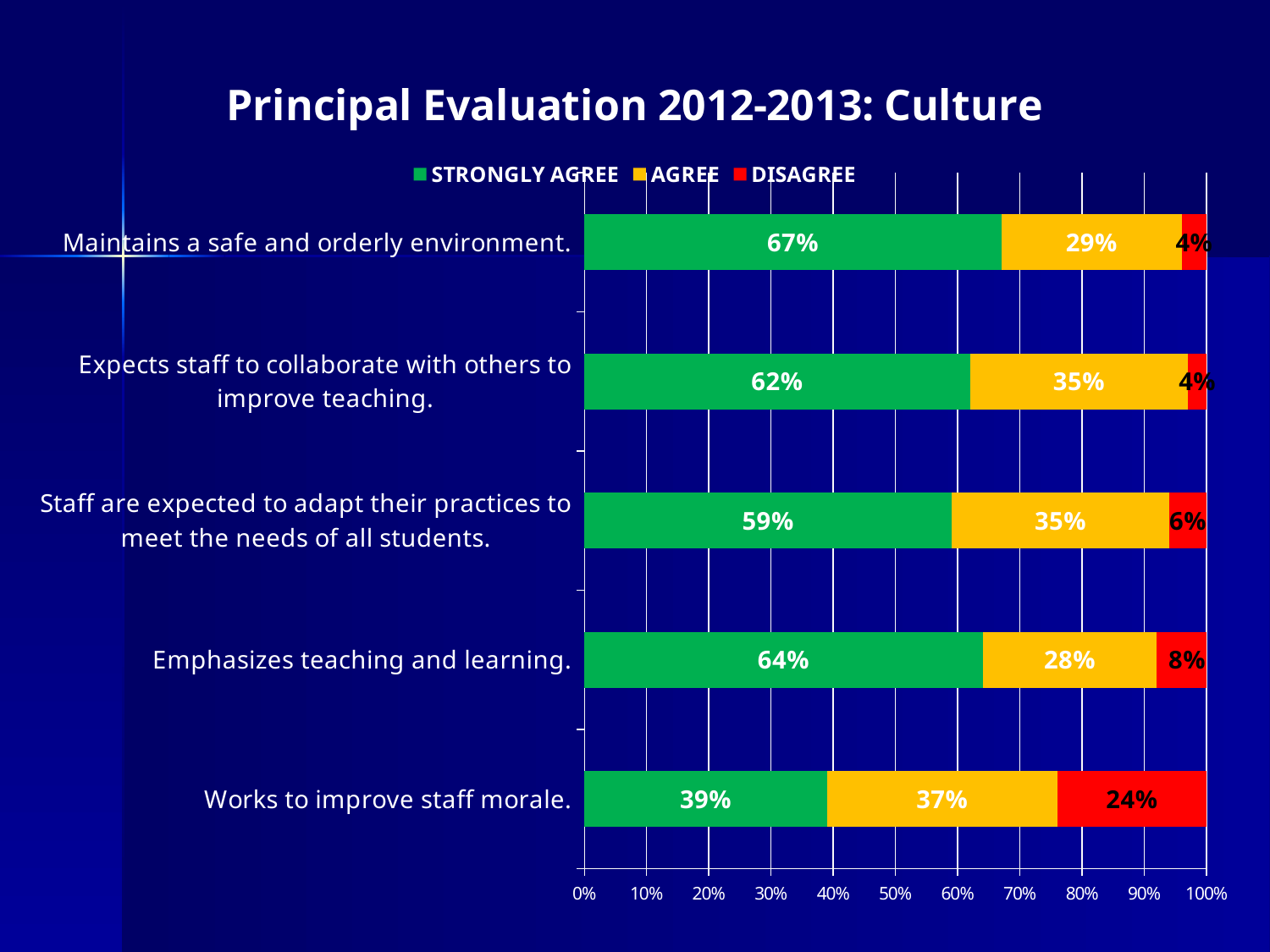
What is the title of the chart? Principal Evaluation 2012-2013: Culture How many series does the legend list? 3 What percentage of respondents strongly agree that the principal maintains a safe and orderly environment? 67% What is the Agree value for "Expects staff to collaborate with others to improve teaching."? 35% Which is larger: the Agree value for "Emphasizes teaching and learning." or the Agree value for "Works to improve staff morale."? Works to improve staff morale. What is the difference between the Strongly Agree values for "Maintains a safe and orderly environment." and "Works to improve staff morale."? 28% How many categories are shown on the chart? 5 What is the Disagree value for "Works to improve staff morale."? 24% Which category has the highest Strongly Agree percentage? Maintains a safe and orderly environment. Which category has the highest Disagree percentage? Works to improve staff morale. Which category has the lowest Strongly Agree percentage? Works to improve staff morale. What kind of chart is shown on the slide? Stacked bar chart